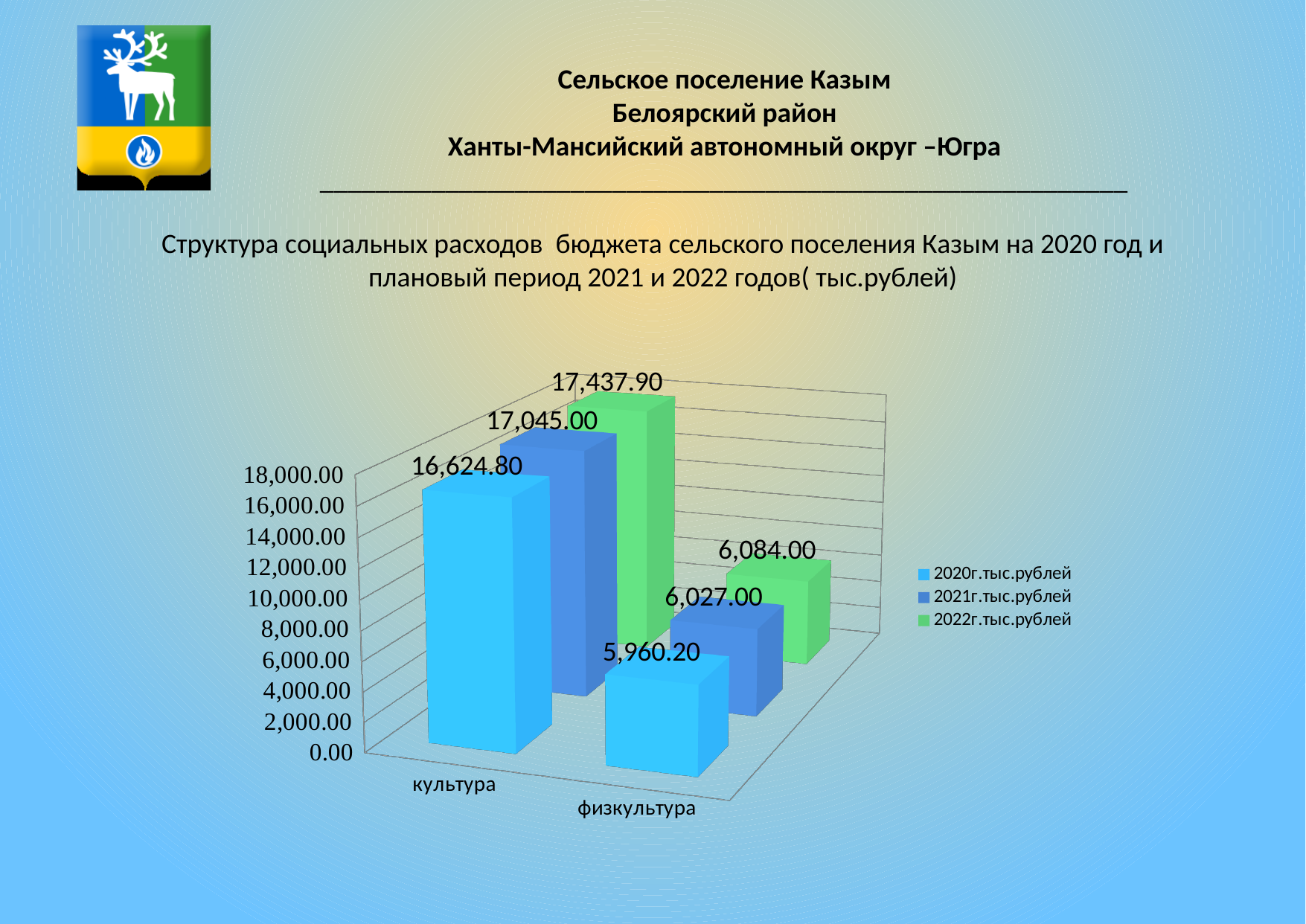
What is the value for культура in the 2020г.тыс.рублей series? 16,624.80 How many series does the legend list? 3 What kind of chart is shown on the slide? bar chart How many categories are shown on the x axis of the chart? 2 What is the value for культура in the 2021г.тыс.рублей series? 17,045.00 Which category has the highest value in the 2022г.тыс.рублей series? культура What is the value for физкультура in the 2022г.тыс.рублей series? 6,084.00 What is the difference between the 2022г.тыс.рублей and 2020г.тыс.рублей values for культура? 813.10 Which is larger: the 2020г.тыс.рублей value for культура or the 2020г.тыс.рублей value for физкультура? культура What is the value for физкультура in the 2020г.тыс.рублей series? 5,960.20 Which category has the lowest value in the 2021г.тыс.рублей series? физкультура What is the difference between the 2021г.тыс.рублей and 2020г.тыс.рублей values for физкультура? 66.80